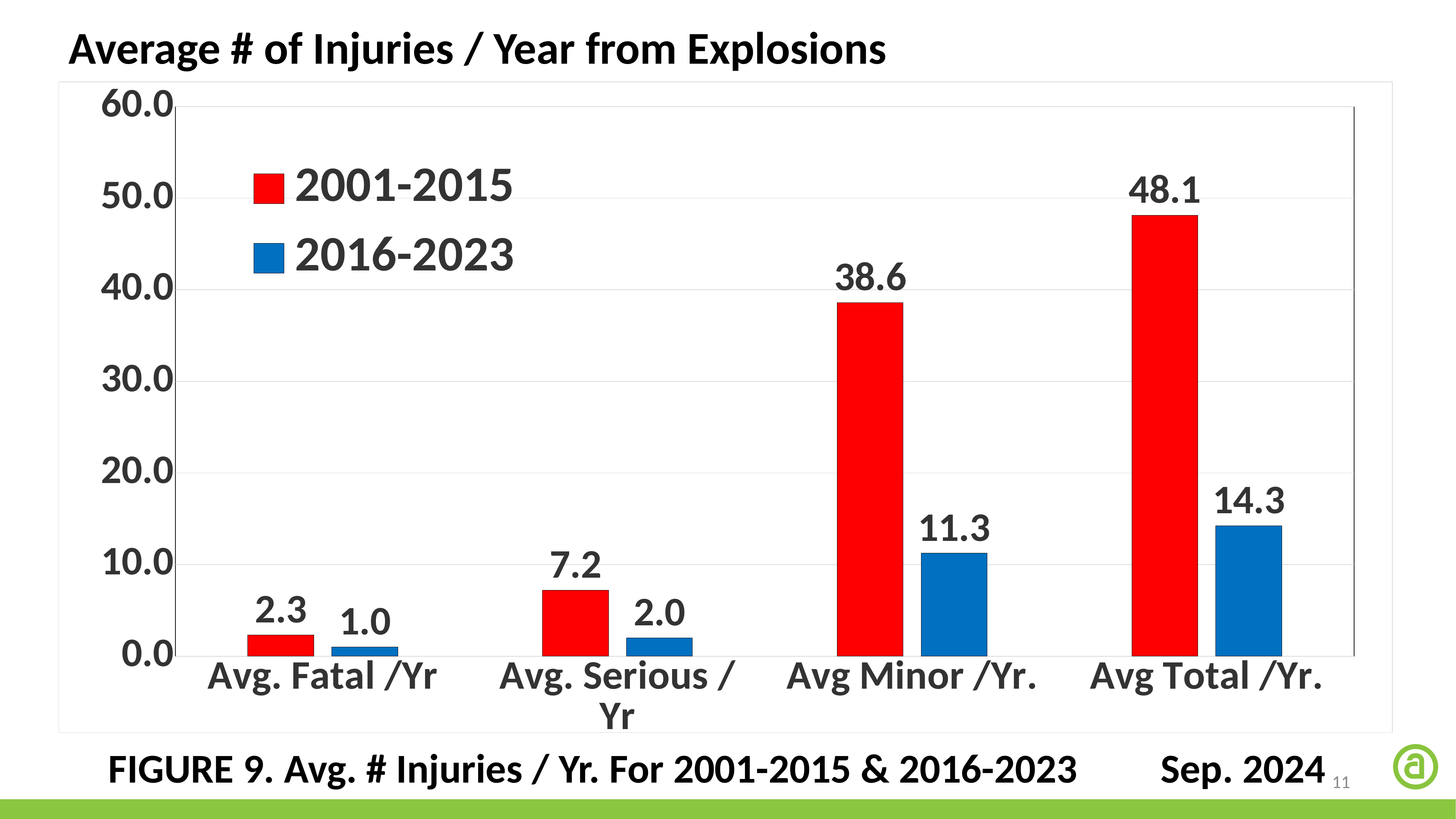
Which category has the highest value in the 2001-2015 series? Avg Total /Yr. What is the difference between the 2001-2015 and 2016-2023 values for Avg Total /Yr.? 33.8 How many series does the legend list? 2 What is the value for Avg Minor /Yr. in the 2001-2015 series? 38.6 What kind of chart is shown on the slide? Bar chart What is the difference between the 2001-2015 and 2016-2023 values for Avg Minor /Yr.? 27.3 How many categories are shown on the x axis? 4 What is the value for Avg. Fatal /Yr in the 2016-2023 series? 1.0 Which is larger: the 2016-2023 value for Avg Minor /Yr. or the 2001-2015 value for Avg. Serious / Yr? 2016-2023 value for Avg Minor /Yr. What is the value for Avg. Serious / Yr in the 2001-2015 series? 7.2 Which category has the lowest value in the 2016-2023 series? Avg. Fatal /Yr What is the value for Avg Total /Yr. in the 2016-2023 series? 14.3